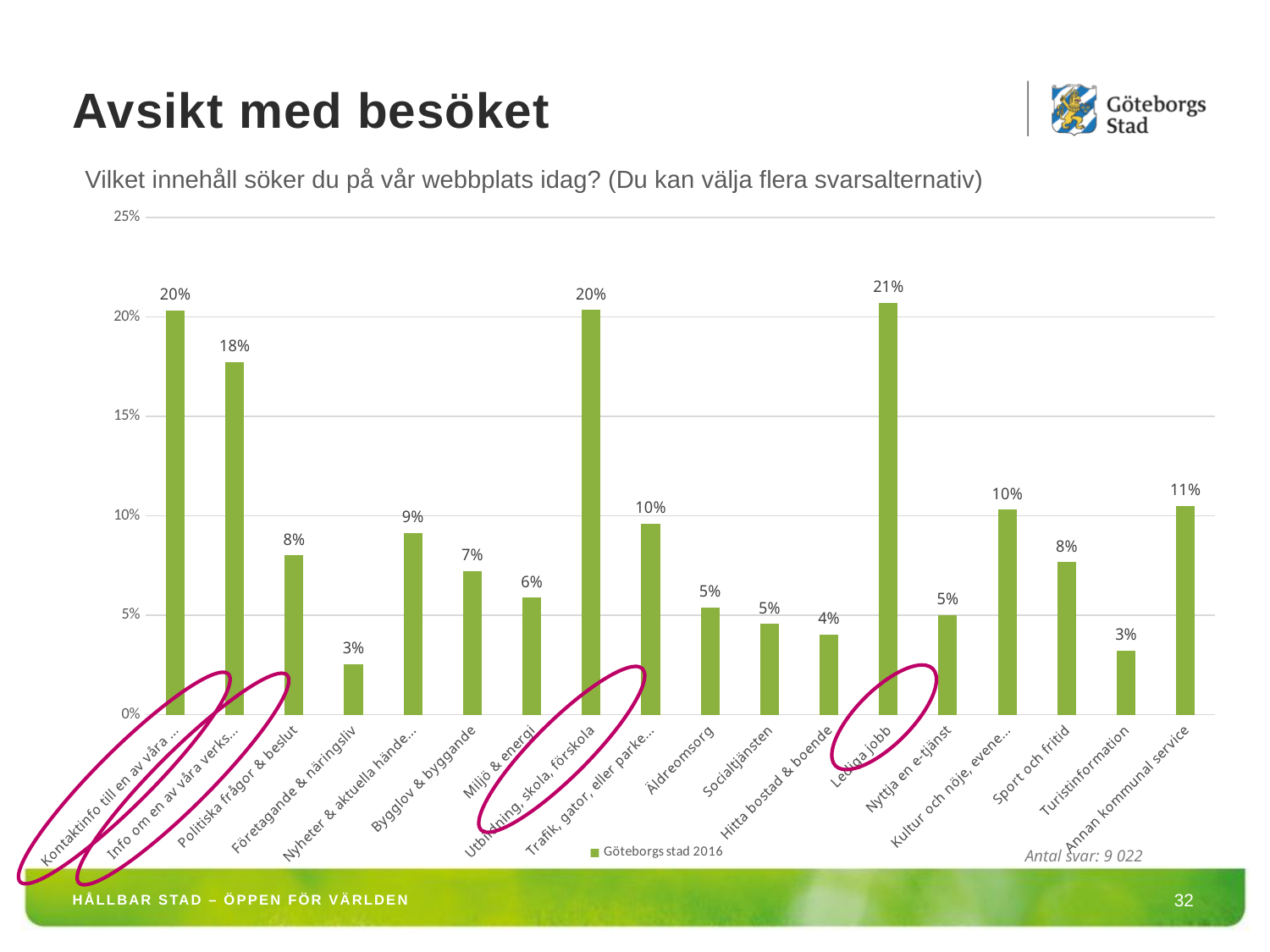
Which category has the highest value? Lediga jobb How many series does the legend list? 1 Which has a larger value, Annan kommunal service or Sport och fritid? Annan kommunal service What is the value for Hitta bostad & boende? 4% What is the value for Lediga jobb? 21% What is the value for Bygglov & byggande? 7% Is the value for Företagande & näringsliv greater or less than 5%? less What kind of chart is shown on the slide? Bar chart What is the difference between the values for Lediga jobb and Socialtjänsten? 16 percentage points What is the value for Turistinformation? 3% How many categories are shown on the x axis? 18 What is the value for Annan kommunal service? 11%